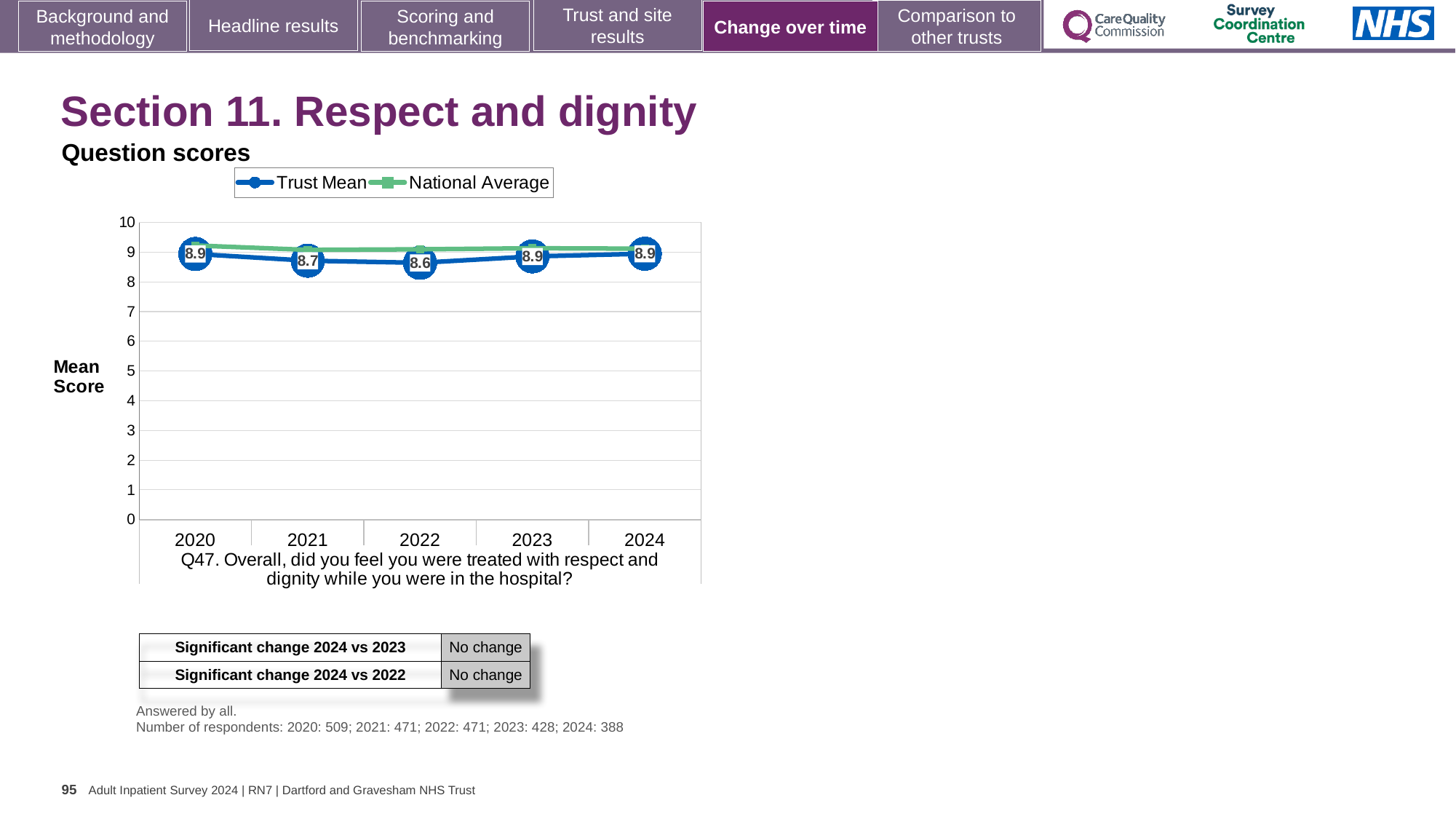
In which year is the Trust Mean score lowest? 2022 What is the Trust Mean score for 2024? 8.9 Does the Trust Mean score rise or fall from 2022 to 2023? Rise How many series does the legend list? 2 What is the Trust Mean score for 2021? 8.7 What kind of chart is shown on the slide? Line chart What is the difference between the Trust Mean scores for 2020 and 2022? 0.3 Which year has the higher Trust Mean score, 2021 or 2022? 2021 What is the Trust Mean score for 2022? 8.6 What are the two series named in the legend? Trust Mean and National Average Is the National Average value for 2020 greater or less than 8? greater How many years are plotted on the x axis? 5